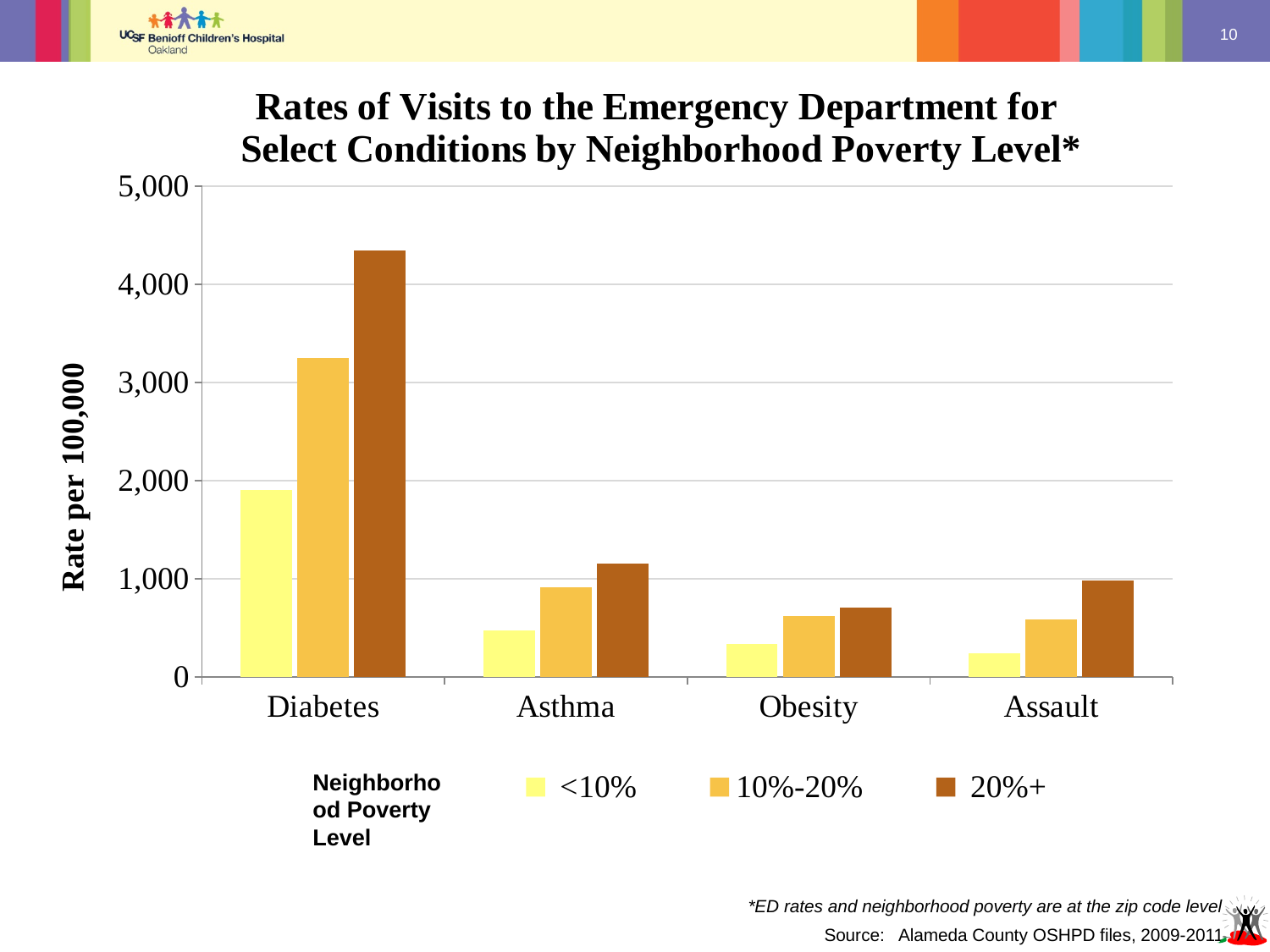
How many series does the legend list? 3 Is the value for Diabetes at the <10% poverty level greater or less than 2,000? less What is the label on the y axis? Rate per 100,000 Is the value for Diabetes at the 20%+ poverty level greater or less than 4,000? greater Which condition has the highest ED visit rate for the 20%+ neighborhood poverty level? Diabetes Which is larger: the 20%+ value for Asthma or the 20%+ value for Obesity? Asthma Is the value for Obesity at the 20%+ poverty level greater or less than 1,000? less Which condition has the lowest ED visit rate for the <10% neighborhood poverty level? Assault How many condition categories are shown on the x axis? 4 What kind of chart is shown on the slide? bar chart